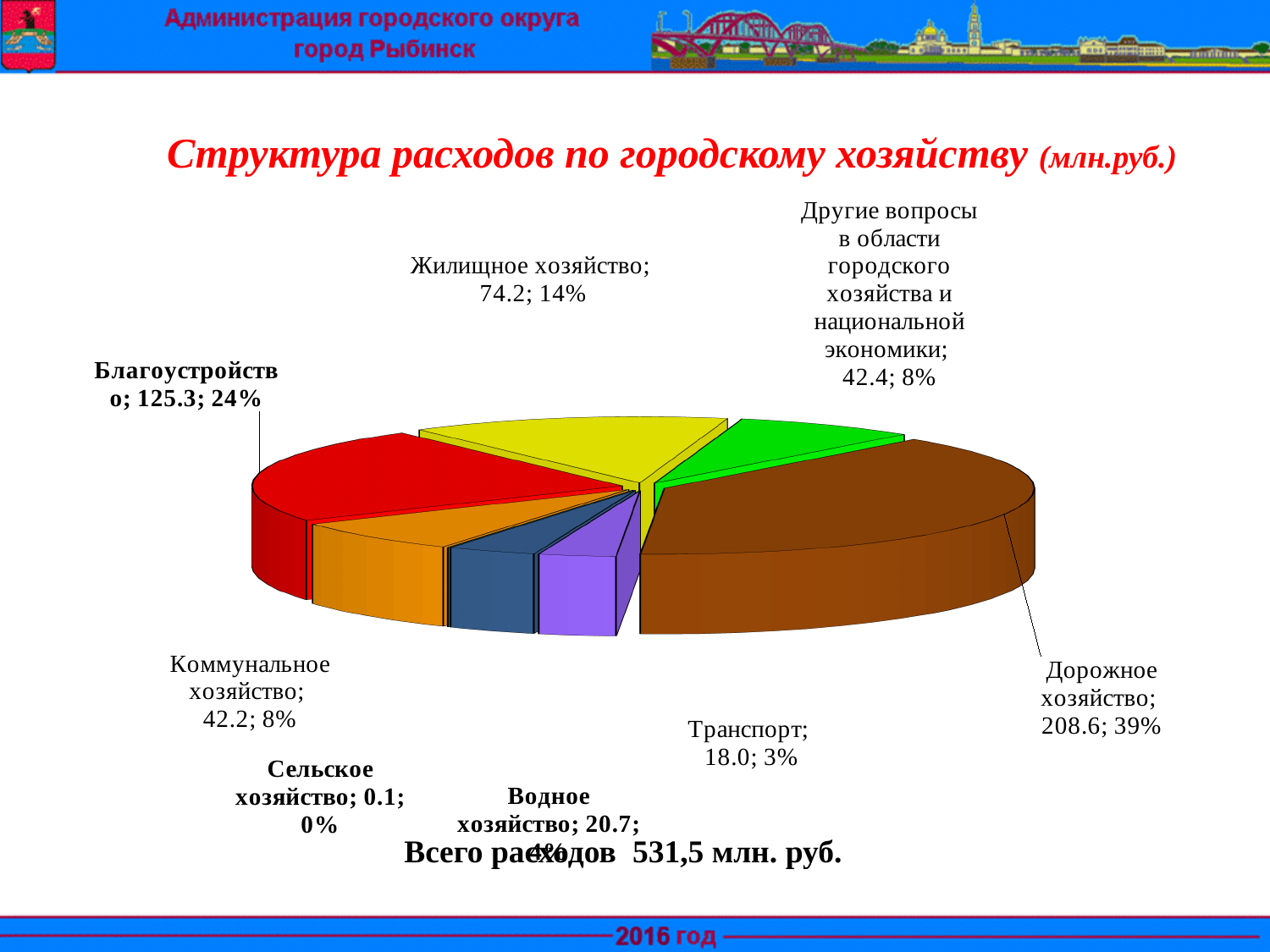
What is the value for Транспорт? 18.0 Which category has the smallest value? Сельское хозяйство Which is larger, the value for Жилищное хозяйство or the value for Коммунальное хозяйство? Жилищное хозяйство What kind of chart is shown on the slide? pie chart What is the value for Дорожное хозяйство? 208.6 What share of the pie does Благоустройство represent? 24% Which category has the largest value? Дорожное хозяйство What is the value for Благоустройство? 125.3 How many categories are shown in the pie chart? 8 What is the value for Жилищное хозяйство? 74.2 What share of the pie does Дорожное хозяйство represent? 39% What is the difference between the values for Дорожное хозяйство and Благоустройство? 83.3